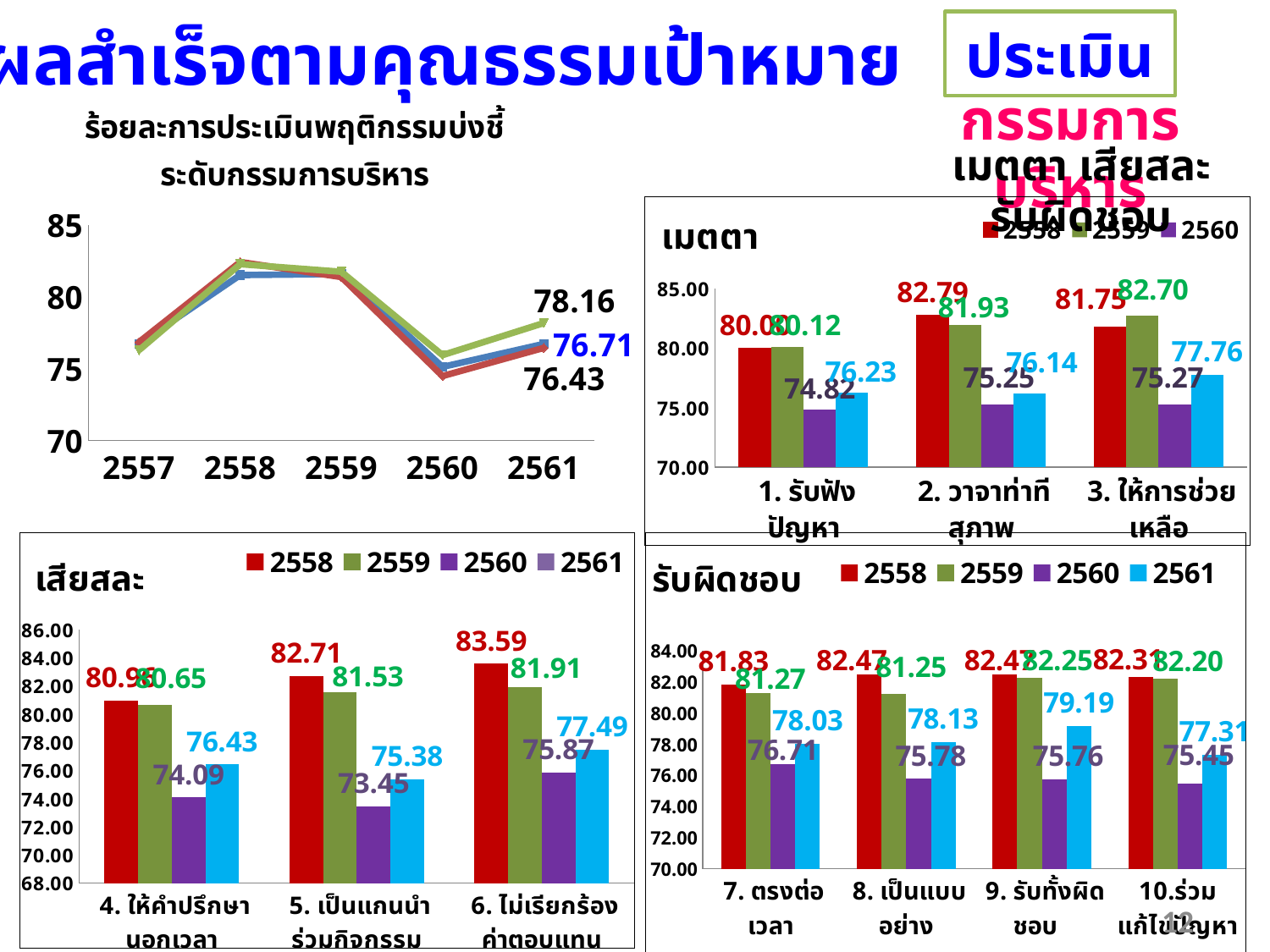
In the เสียสละ chart, what is the value for 2558 in category 6. ไม่เรียกร้องค่าตอบแทน? 83.59 In the เมตตา chart, what is the difference between the 2558 and 2560 values for 2. วาจาท่าทีสุภาพ? 7.54 In the top-left line chart, what is the highest value labelled at 2561? 78.16 In the รับผิดชอบ chart, which category has the lowest 2560 value? 10.ร่วมแก้ไขปัญหา How many categories are shown on the x axis of the รับผิดชอบ chart? 4 How many series does the legend of the เสียสละ chart list? 4 In the เมตตา chart, what is the value for 2559 in category 3. ให้การช่วยเหลือ? 82.70 In the รับผิดชอบ chart, what is the value for 2561 in category 9. รับทั้งผิดชอบ? 79.19 In the เสียสละ chart, which category has the highest 2561 value? 6. ไม่เรียกร้องค่าตอบแทน In the เสียสละ chart, what is the value for 2560 in category 5. เป็นแกนนำร่วมกิจกรรม? 73.45 In the รับผิดชอบ chart, is the 2561 value for 7. ตรงต่อเวลา larger or smaller than the 2561 value for 8. เป็นแบบอย่าง? smaller What kind of chart is the top-left chart titled ร้อยละการประเมินพฤติกรรมบ่งชี้ ระดับกรรมการบริหาร? line chart